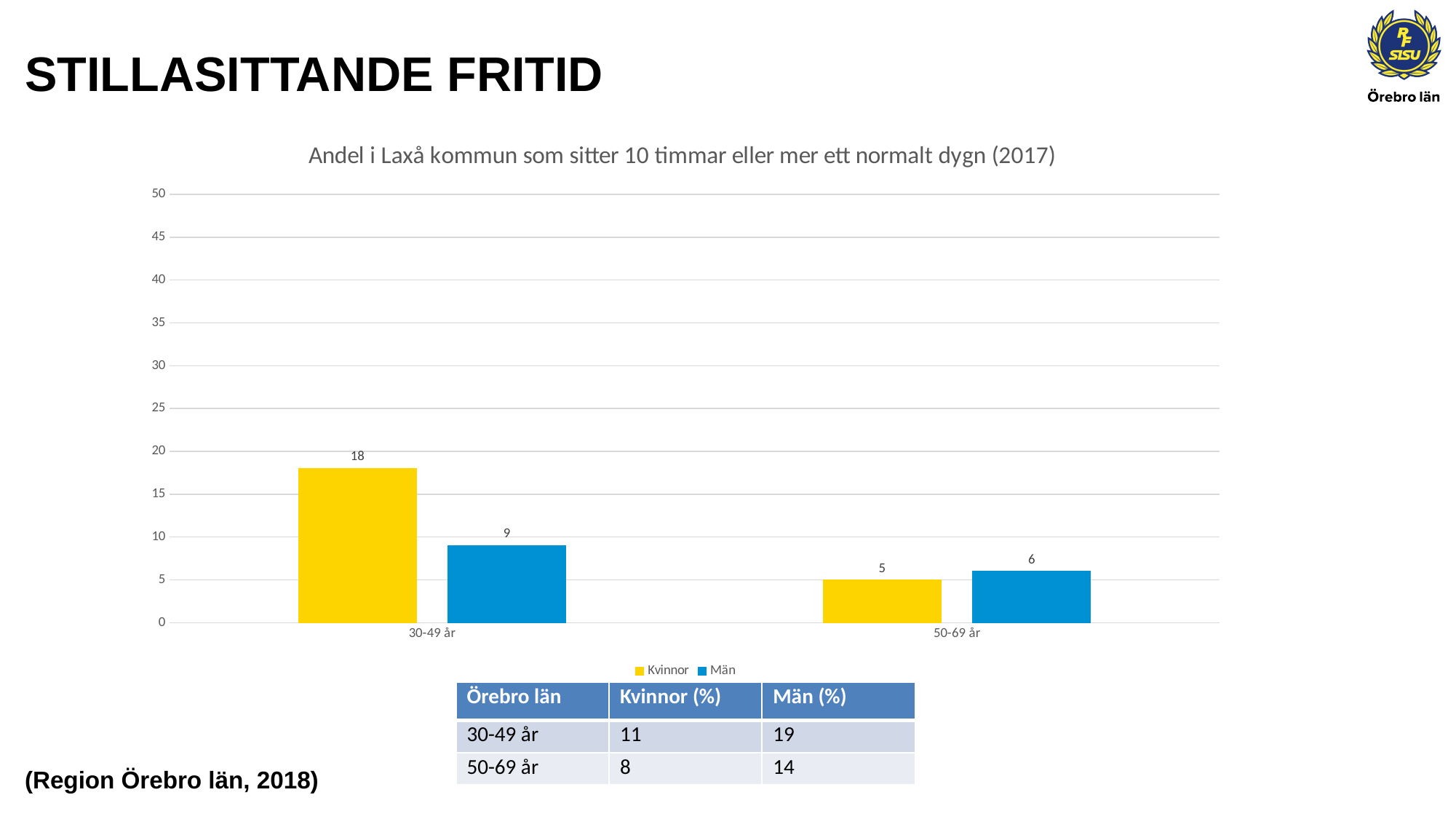
What is the difference between the Kvinnor and Män values in the 30-49 år category? 9 How many age categories are shown on the x axis? 2 What is the value for Män in the 50-69 år category? 6 How many series does the legend list? 2 Which bar has the highest value in the chart? Kvinnor, 30-49 år Which bar has the lowest value in the chart? Kvinnor, 50-69 år What colour are the Kvinnor bars? Yellow What kind of chart is shown on the slide? Bar chart In the 50-69 år category, which is larger, Kvinnor or Män? Män What is the value for Kvinnor in the 30-49 år category? 18 What is the value for Män in the 30-49 år category? 9 What is the value for Kvinnor in the 50-69 år category? 5